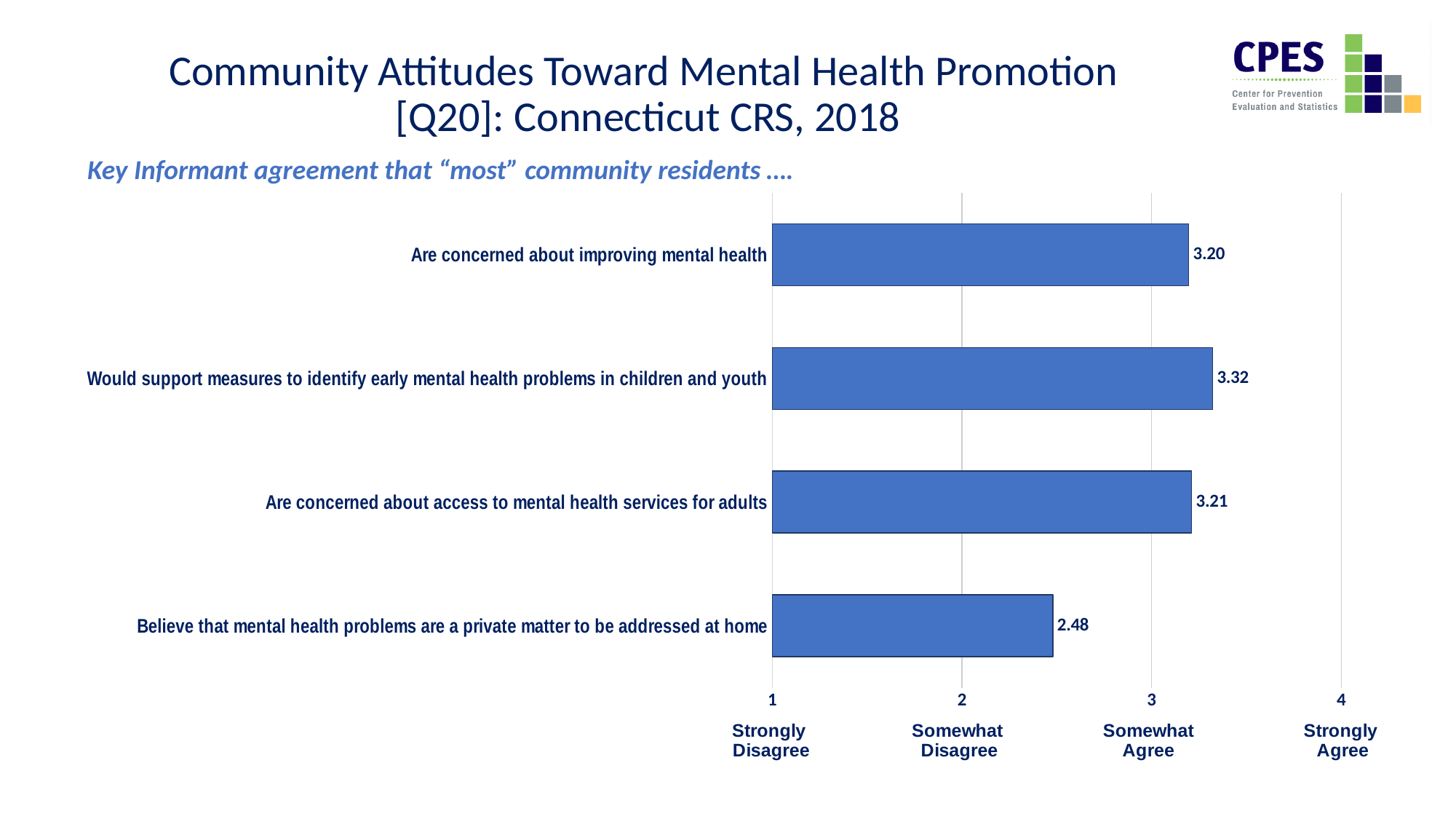
Which is larger: the value for "Are concerned about improving mental health" or the value for "Believe that mental health problems are a private matter to be addressed at home"? Are concerned about improving mental health What is the value for "Are concerned about improving mental health"? 3.20 How many categories are shown in the chart? 4 What kind of chart is shown on the slide? bar chart Which category has the lowest value? Believe that mental health problems are a private matter to be addressed at home What label does the x axis show at the value 4? Strongly Agree What is the value for "Would support measures to identify early mental health problems in children and youth"? 3.32 What is the difference between the values for "Would support measures to identify early mental health problems in children and youth" and "Believe that mental health problems are a private matter to be addressed at home"? 0.84 What is the value for "Are concerned about access to mental health services for adults"? 3.21 Is the value for "Believe that mental health problems are a private matter to be addressed at home" greater or less than 3? less What is the value for "Believe that mental health problems are a private matter to be addressed at home"? 2.48 Which category has the highest value? Would support measures to identify early mental health problems in children and youth